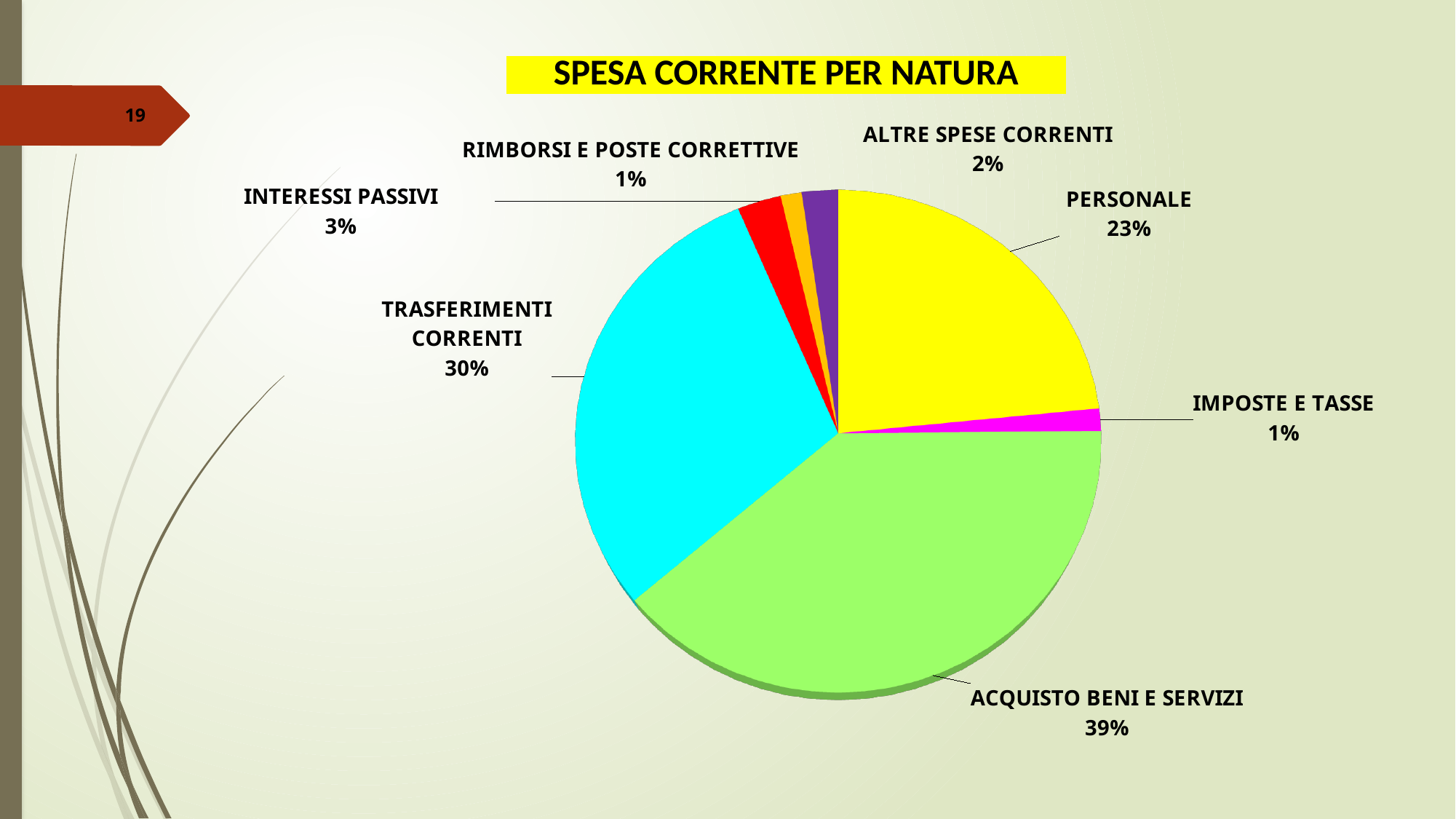
What is the value shown for INTERESSI PASSIVI? 3% What is the title of the chart? SPESA CORRENTE PER NATURA What share of the pie does ACQUISTO BENI E SERVIZI represent? 39% Which is larger, the share for PERSONALE or the share for TRASFERIMENTI CORRENTI? TRASFERIMENTI CORRENTI What is the value shown for TRASFERIMENTI CORRENTI? 30% What colour is the slice for PERSONALE? yellow What is the difference between the shares of ACQUISTO BENI E SERVIZI and TRASFERIMENTI CORRENTI? 9% What is the value shown for PERSONALE? 23% Which category has the largest slice of the pie? ACQUISTO BENI E SERVIZI What is the value shown for ALTRE SPESE CORRENTI? 2% How many slices does the pie chart have? 7 What kind of chart is shown on the slide? pie chart